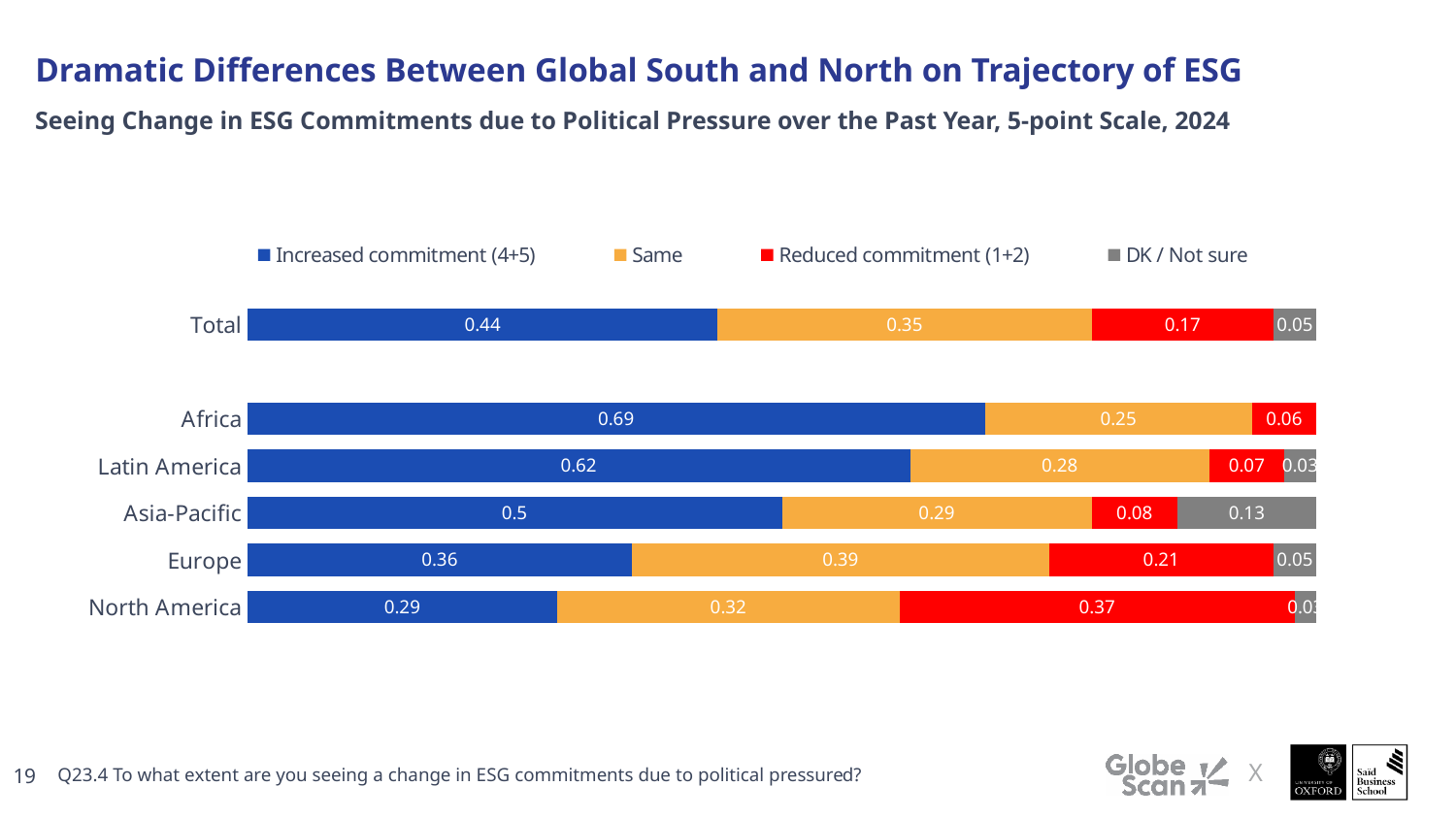
What type of chart is shown on the slide? Stacked bar chart Which is larger: the Reduced commitment (1+2) value for Europe or for Asia-Pacific? Europe What is the Reduced commitment (1+2) value for North America? 0.37 What is the Increased commitment (4+5) value for Africa? 0.69 What is the DK / Not sure value for Asia-Pacific? 0.13 Which region has the highest Increased commitment (4+5) value? Africa How many regions (excluding Total) are plotted in the chart? 5 What is the total of the four segments in the Asia-Pacific bar? 1 How many series does the legend list? 4 What is the Same value for Europe? 0.39 Which region has the lowest Increased commitment (4+5) value? North America What is the difference between the Increased commitment (4+5) values for Africa and North America? 0.4